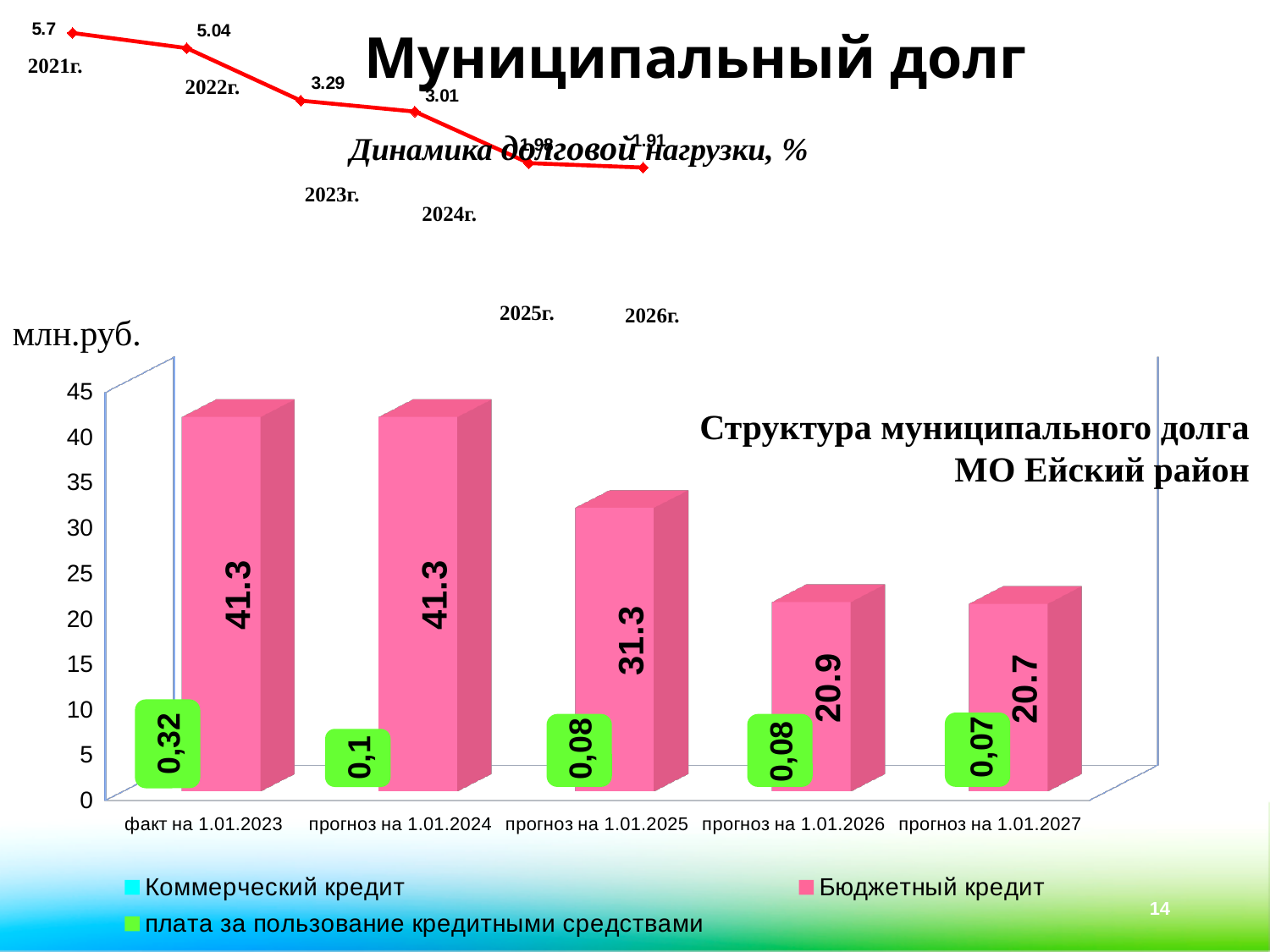
In the line chart 'Динамика долговой нагрузки, %', what is the value for 2021г.? 5.7 In the bar chart 'Структура муниципального долга МО Ейский район', what is the value of Бюджетный кредит for 'прогноз на 1.01.2027'? 20.7 In the line chart 'Динамика долговой нагрузки, %', what is the value for 2023г.? 3.29 In the bar chart 'Структура муниципального долга МО Ейский район', what is the value of 'плата за пользование кредитными средствами' for 'факт на 1.01.2023'? 0,32 In the bar chart 'Структура муниципального долга МО Ейский район', what is the difference between the Бюджетный кредит values for 'прогноз на 1.01.2024' and 'прогноз на 1.01.2025'? 10 How many series does the legend of the bar chart 'Структура муниципального долга МО Ейский район' list? 3 In the bar chart 'Структура муниципального долга МО Ейский район', what is the value of Бюджетный кредит for 'факт на 1.01.2023'? 41.3 In the bar chart 'Структура муниципального долга МО Ейский район', which category has the lowest Бюджетный кредит value? прогноз на 1.01.2027 How many categories are shown on the x axis of the bar chart 'Структура муниципального долга МО Ейский район'? 5 In the line chart 'Динамика долговой нагрузки, %', do the values rise or fall from 2021г. to 2026г.? fall In the bar chart 'Структура муниципального долга МО Ейский район', is the Бюджетный кредит value for 'прогноз на 1.01.2025' larger or smaller than for 'прогноз на 1.01.2026'? larger What kind of chart is 'Структура муниципального долга МО Ейский район'? bar chart